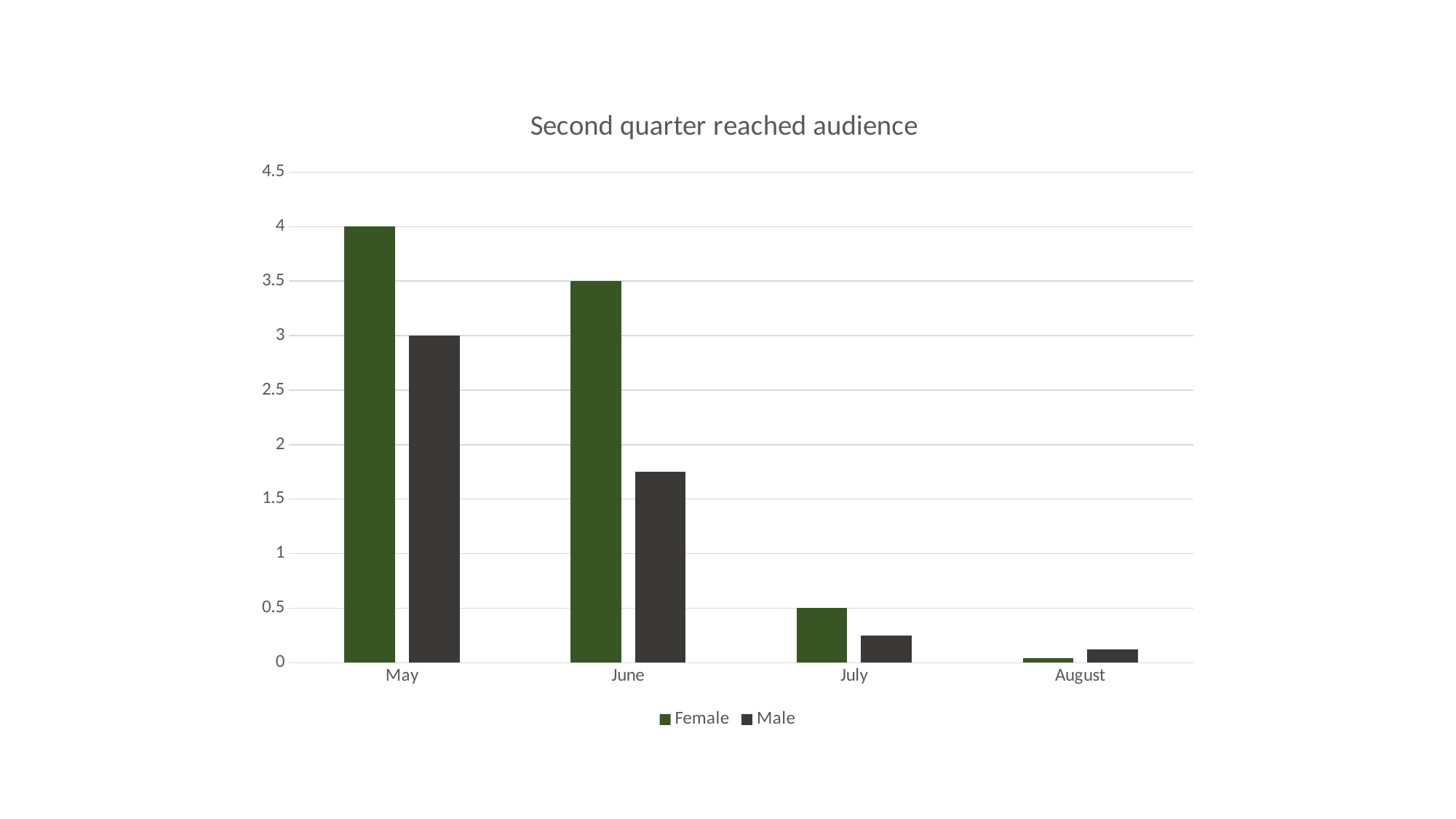
What is the Male value for May? 3 What is the title of the chart? Second quarter reached audience What type of chart is shown on the slide? bar chart What is the Female value for June? 3.5 How many months are shown on the x axis? 4 In which month is the Female value lowest? August Do the Female values rise or fall from May to August? fall What is the difference between the Female and Male values for May? 1 What is the Female value for May? 4 In which month is the Female value highest? May Is the Male value for June greater or less than 2? less How many series does the legend list? 2